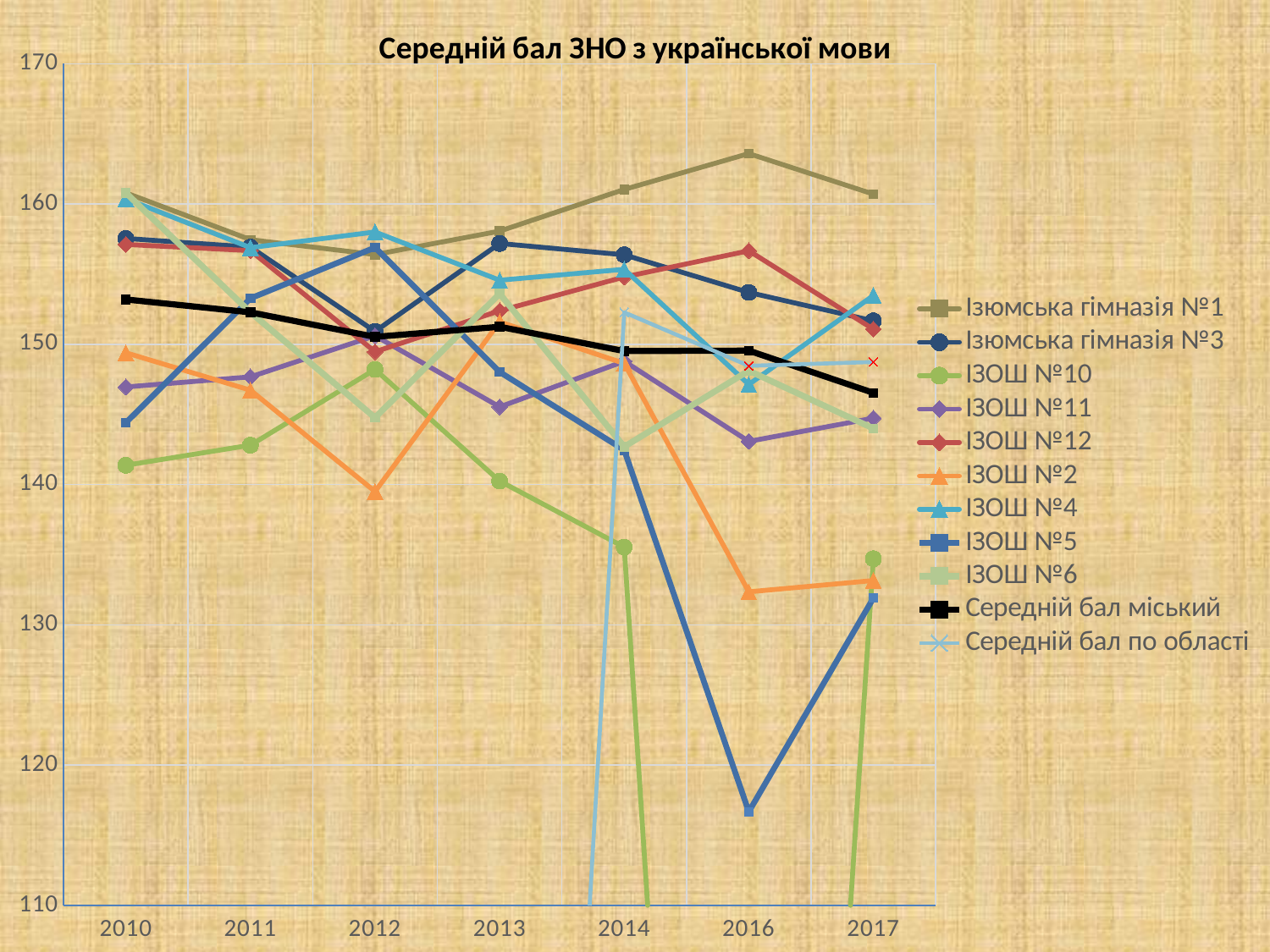
How many years are shown on the x axis? 7 Is the value for ІЗОШ №5 in 2016 greater or less than 120? less What type of chart is shown on the slide? line chart Is the value for ІЗОШ №10 in 2014 greater or less than 140? less Is the value for Середній бал міський in 2017 greater or less than 150? less How many series does the legend list? 11 Which series has the highest value in 2016? Ізюмська гімназія №1 What is the title of the chart? Середній бал ЗНО з української мови Does the value for Ізюмська гімназія №1 rise or fall from 2012 to 2016? rise Does the value for ІЗОШ №5 rise or fall from 2014 to 2016? fall